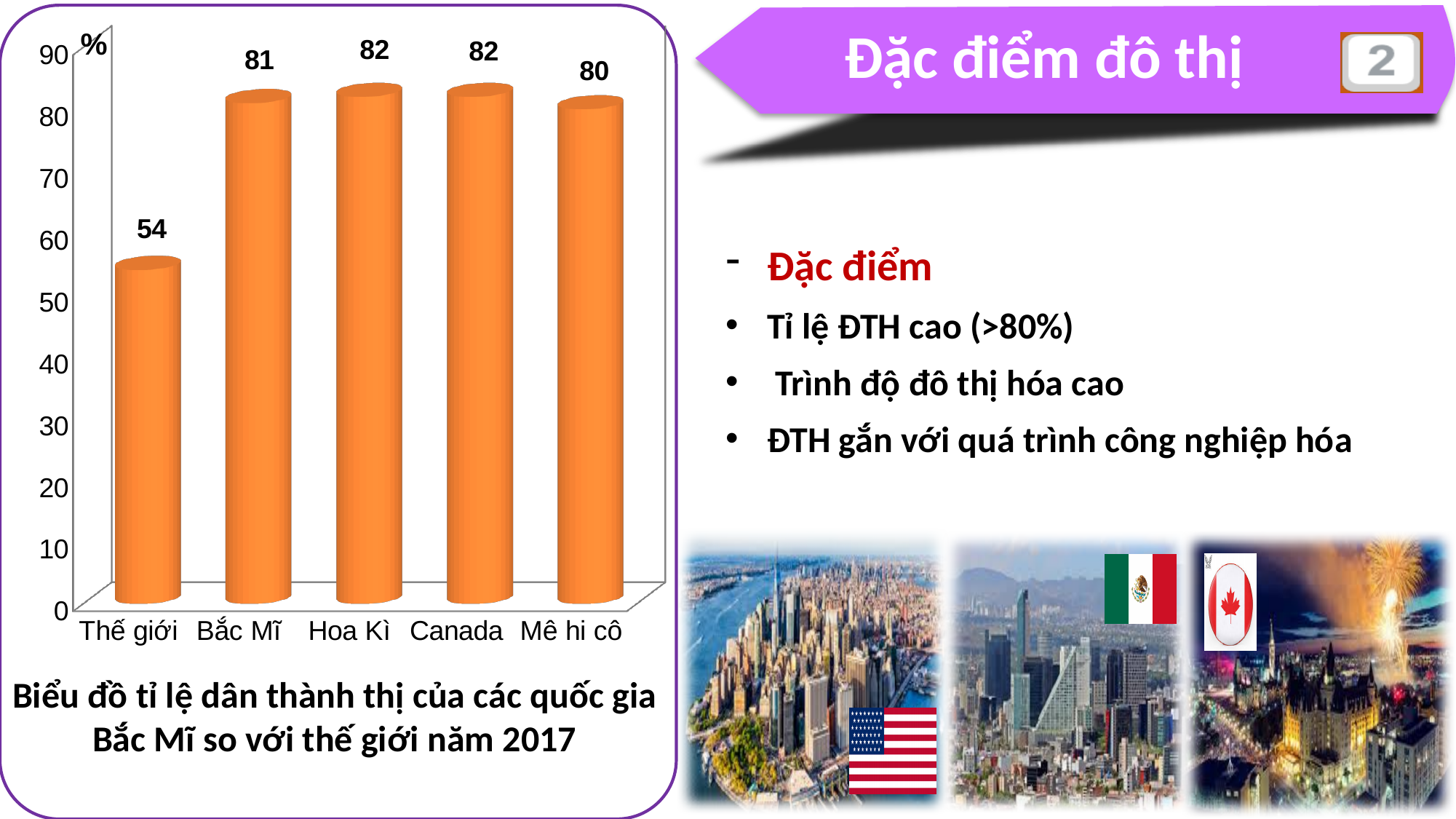
What is the value for Bắc Mĩ? 81 What is the difference between the values for Canada and Mê hi cô? 2 What is the value for Mê hi cô? 80 What unit is shown on the vertical axis of the chart? % What is the value for Hoa Kì? 82 Which category has the lowest value? Thế giới Is the value for Thế giới greater or less than 60? less What is the value for Thế giới? 54 What kind of chart is shown on the slide? bar chart What is the difference between the values for Bắc Mĩ and Thế giới? 27 How many categories are shown on the x axis? 5 Which is larger, the value for Hoa Kì or the value for Mê hi cô? Hoa Kì